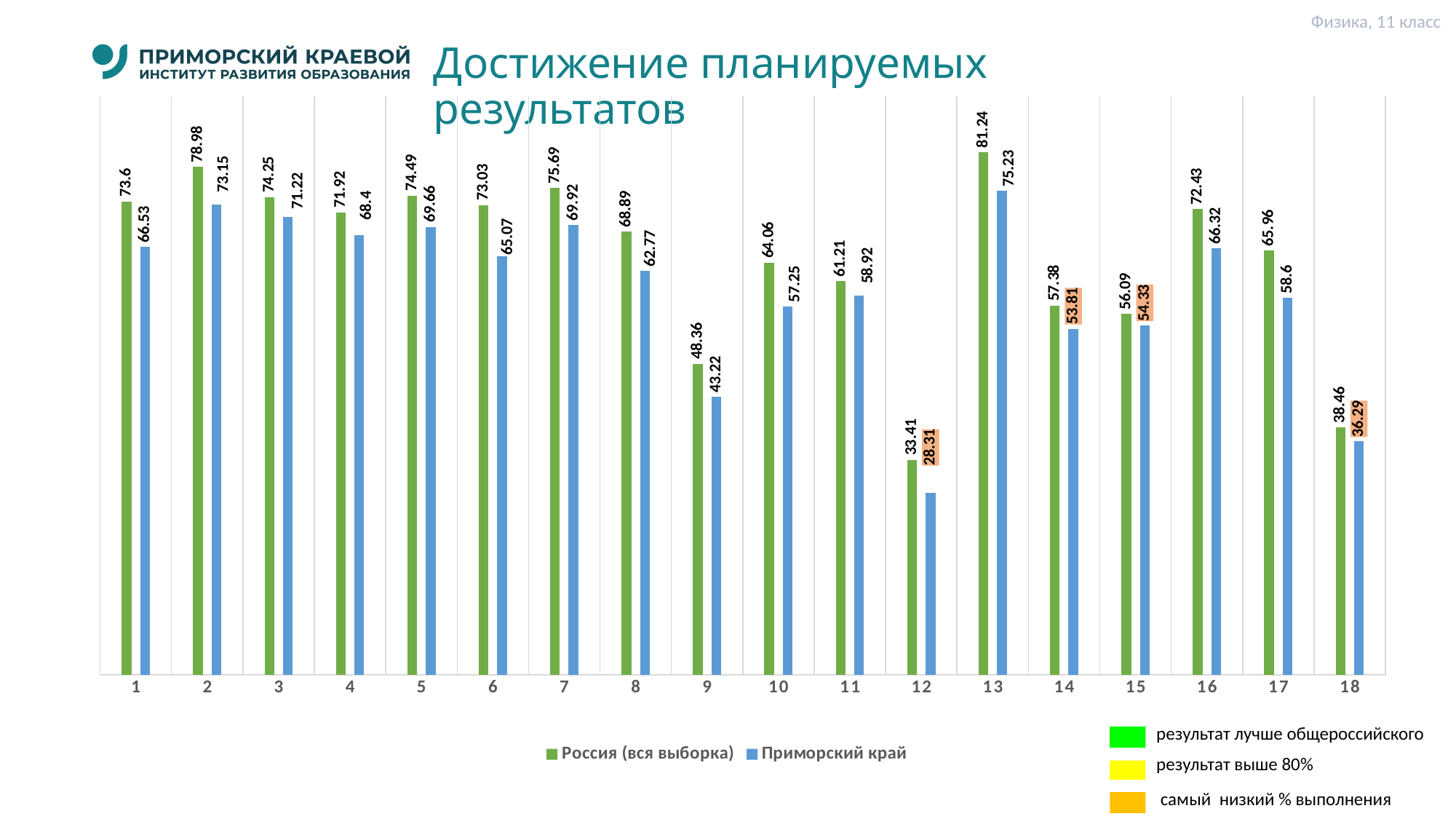
How many series does the chart legend list? 2 Which category has the lowest value for Россия (вся выборка)? 12 What is the difference between the Россия (вся выборка) and Приморский край values for category 1? 7.07 Which is larger for category 15: the value for Россия (вся выборка) or for Приморский край? Россия (вся выборка) What is the value for Россия (вся выборка) for category 13? 81.24 What kind of chart is shown on the slide? bar chart Which category has the highest value for Приморский край? 13 How many categories are shown on the x axis? 18 What is the value for Приморский край for category 12? 28.31 What is the value for Россия (вся выборка) for category 9? 48.36 What is the value for Приморский край for category 7? 69.92 What is the difference between the Приморский край values for category 2 and category 18? 36.86